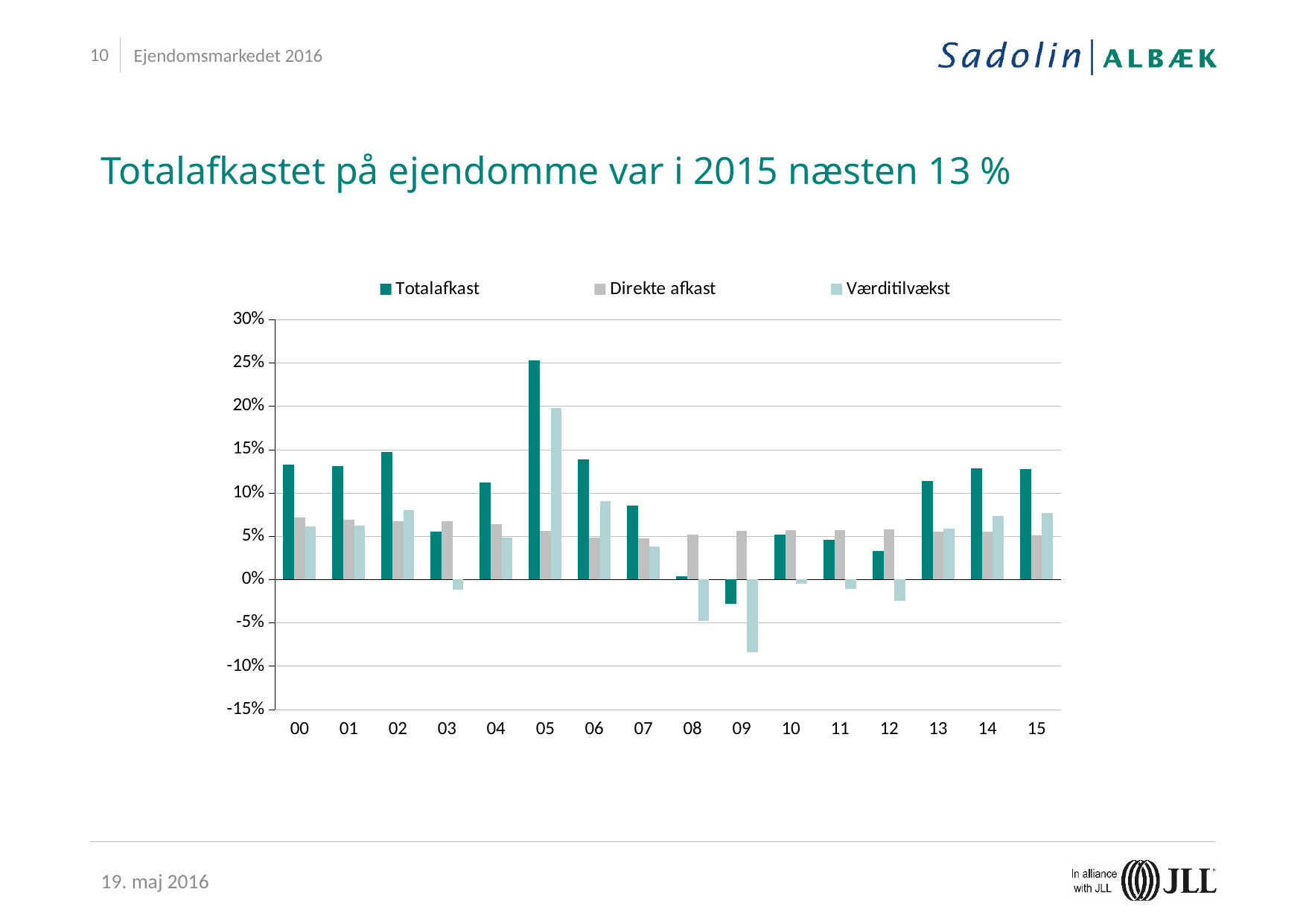
Which series is shown in dark green? Totalafkast What kind of chart is shown on the slide? bar chart In which year is Værditilvækst lowest? 09 How many years are shown on the x axis? 16 In which year is Totalafkast lowest? 09 Is the Totalafkast value for 05 greater or less than 20%? greater Which year has the larger Totalafkast, 02 or 03? 02 How many series does the legend list? 3 In which year is Totalafkast highest? 05 Is the Totalafkast value for 15 greater or less than 10%? greater Is the Værditilvækst value for 09 greater or less than -5%? less Does Totalafkast rise or fall from 05 to 09? fall